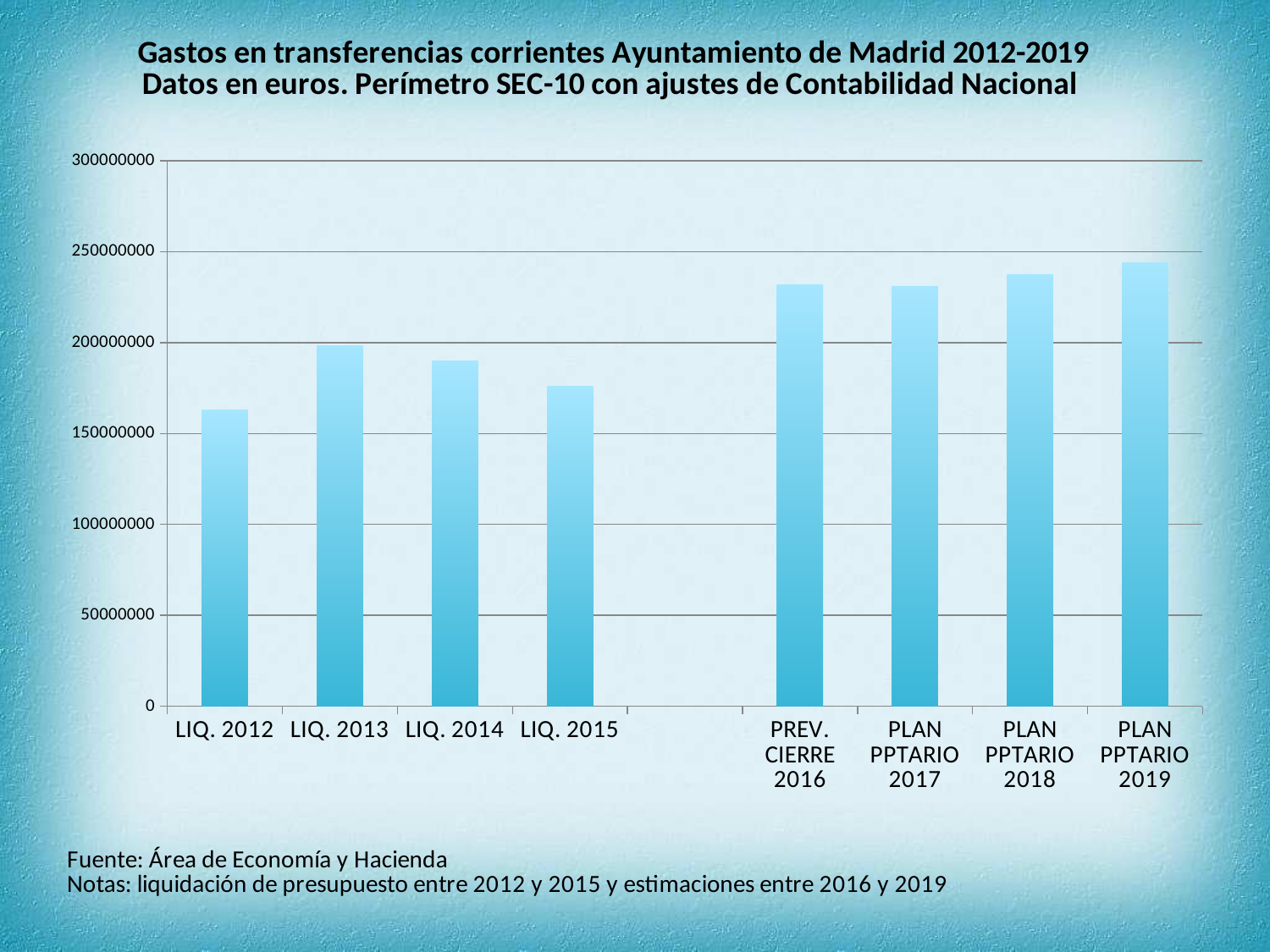
How many bars (categories) are plotted in the chart? 8 Is the value for PLAN PPTARIO 2018 greater or less than 200000000? greater Which category has the highest value in the chart? PLAN PPTARIO 2019 Which category has the lowest value in the chart? LIQ. 2012 What is the first line of the chart's title? Gastos en transferencias corrientes Ayuntamiento de Madrid 2012-2019 What kind of chart is shown on the slide? bar chart Is the value for LIQ. 2012 greater or less than 200000000? less Is the value for LIQ. 2015 greater or less than 150000000? greater Which is larger, the value for LIQ. 2012 or the value for LIQ. 2015? LIQ. 2015 Which is larger, the value for LIQ. 2013 or the value for LIQ. 2014? LIQ. 2013 Do the values rise or fall from PLAN PPTARIO 2017 to PLAN PPTARIO 2019? rise